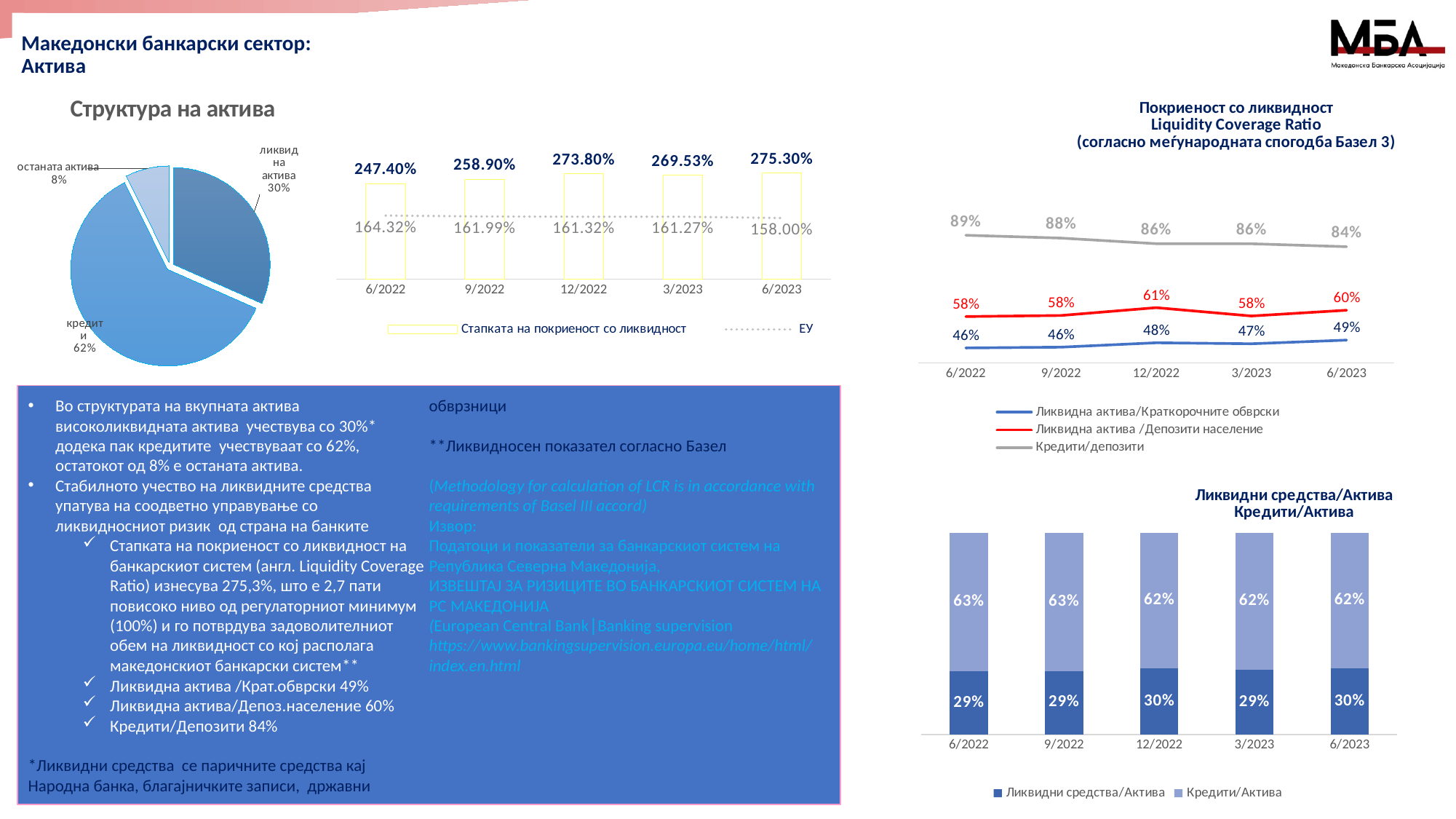
In the bar chart showing 'Стапката на покриеност со ликвидност' and 'ЕУ', what is the difference between 'Стапката на покриеност со ликвидност' and 'ЕУ' in 6/2023? 117.30% In the bar chart showing 'Стапката на покриеност со ликвидност' and 'ЕУ', in which period is 'Стапката на покриеност со ликвидност' lowest? 6/2022 In the pie chart 'Структура на актива', which category has the smallest slice? останата актива In the pie chart 'Структура на актива', how many slices are there? 3 In the bar chart showing 'Стапката на покриеност со ликвидност' and 'ЕУ', what is the 'ЕУ' value for 6/2022? 164.32% In the line chart 'Покриеност со ликвидност / Liquidity Coverage Ratio', does the 'Кредити/депозити' series rise or fall from 6/2022 to 6/2023? fall In the bar chart showing 'Стапката на покриеност со ликвидност' and 'ЕУ', what is the value of 'Стапката на покриеност со ликвидност' for 6/2023? 275.30% In the pie chart 'Структура на актива', what share of assets is 'кредити'? 62% In the line chart 'Покриеност со ликвидност / Liquidity Coverage Ratio', what is the value of 'Кредити/депозити' for 6/2023? 84% In the line chart 'Покриеност со ликвидност / Liquidity Coverage Ratio', how many series does the legend list? 3 In the stacked bar chart 'Ликвидни средства/Актива Кредити/Актива', what is the value of 'Кредити/Актива' for 9/2022? 63% In the line chart 'Покриеност со ликвидност / Liquidity Coverage Ratio', what is the value of 'Ликвидна актива/Краткорочните обврски' for 12/2022? 48%